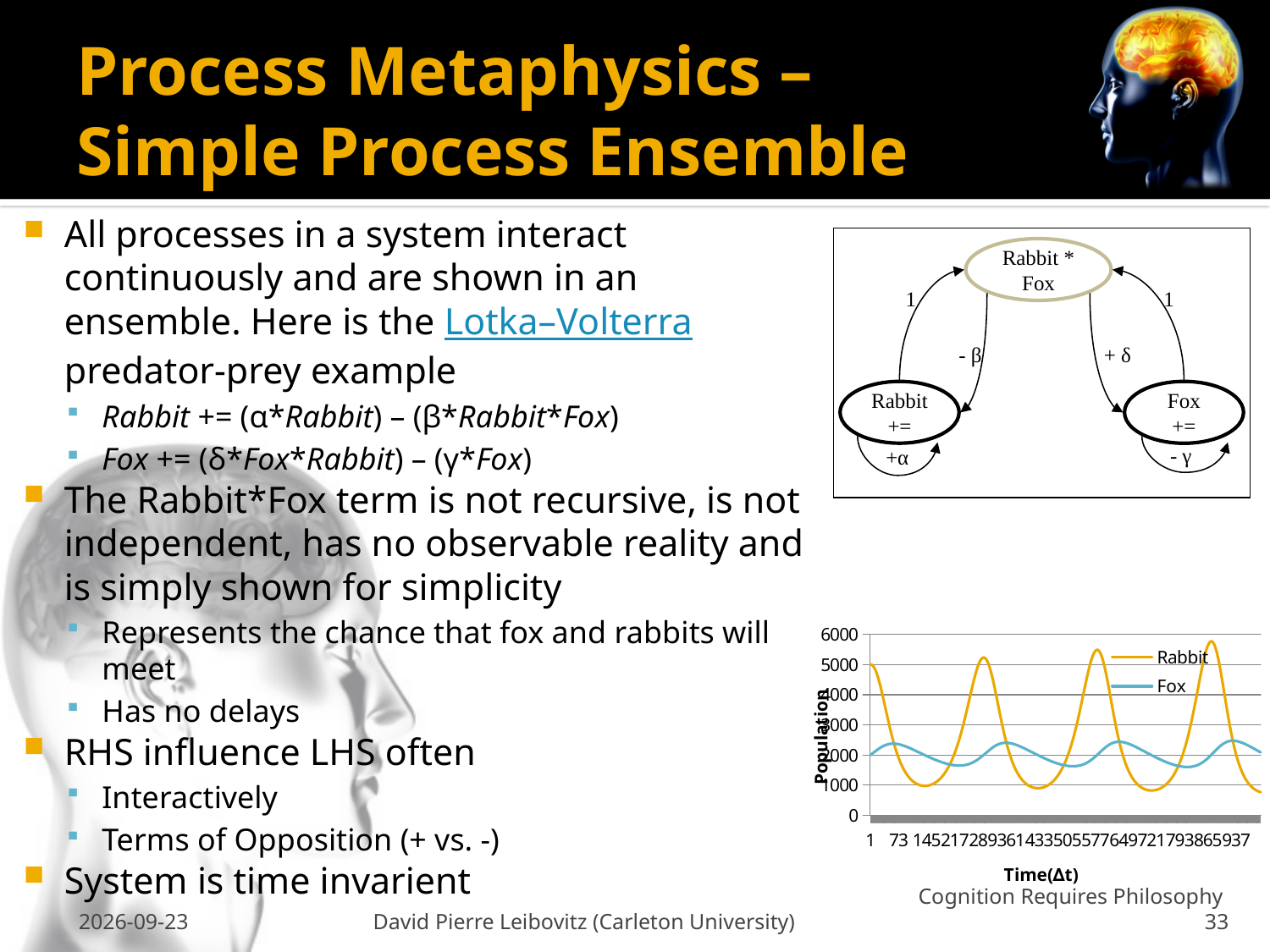
In the line chart, is the lowest value of the Fox series greater or less than 1000? greater In the line chart, is the lowest value of the Rabbit series greater or less than 1000? less What is the title of the horizontal axis of the line chart? Time(Δt) What are the two series named in the legend of the line chart? Rabbit and Fox What is the title of the vertical axis of the line chart? Population How many series does the legend of the line chart list? 2 Do the values of the Rabbit series in the line chart rise steadily, fall steadily, or oscillate along the x axis? oscillate In the line chart, is the highest value of the Fox series greater or less than 3000? less What kind of chart is shown at the bottom right of the slide? line chart In the line chart, which series reaches the higher peak values, Rabbit or Fox? Rabbit